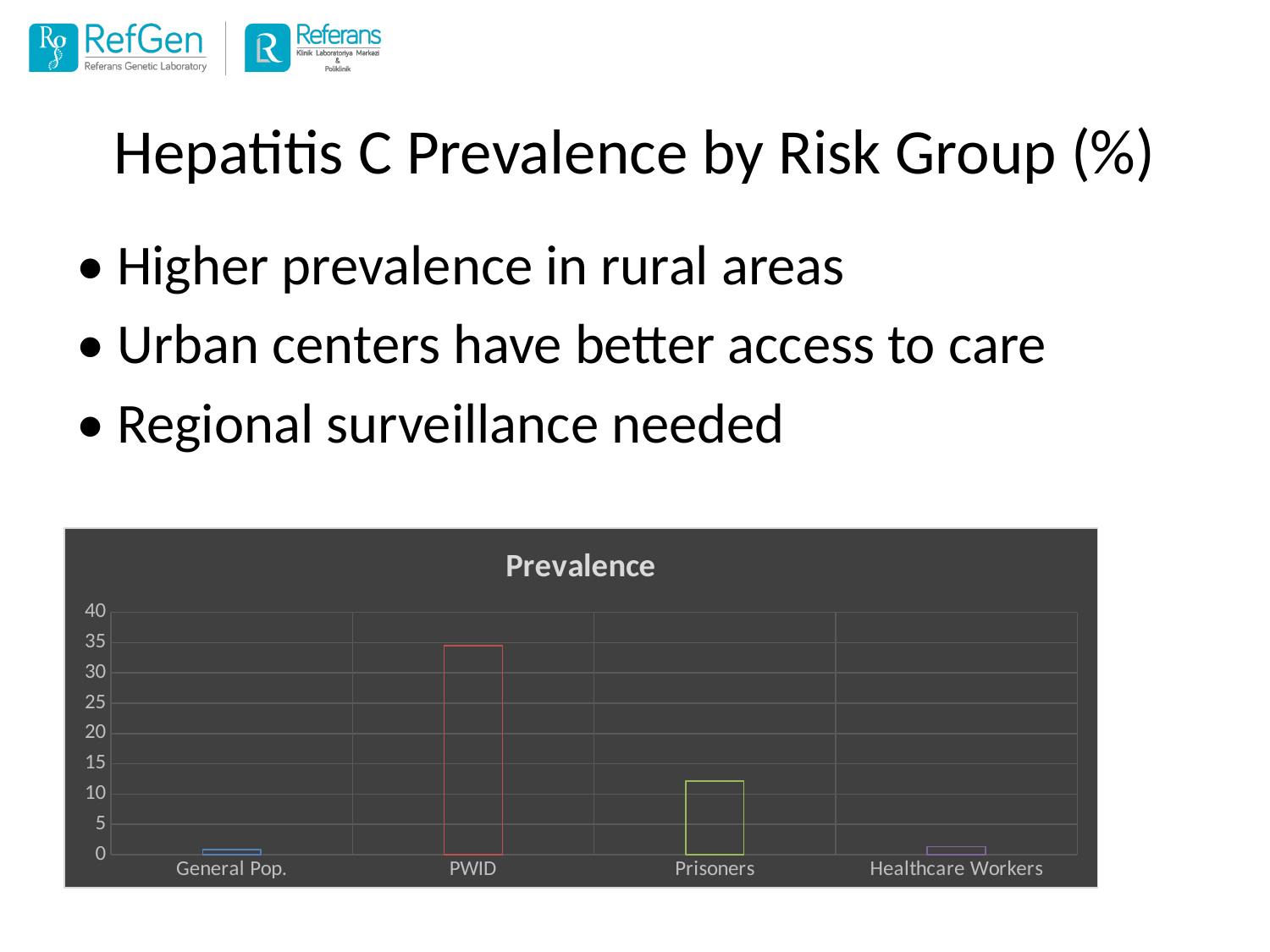
What is the title of the chart? Prevalence Which has a higher prevalence, PWID or Prisoners? PWID Is the value for Healthcare Workers greater or less than 5? less What kind of chart is shown on the slide? bar chart Is the value for PWID greater or less than 30? greater Is the value for Prisoners greater or less than 15? less Which risk group has the highest prevalence in the chart? PWID Which has a higher prevalence, Prisoners or Healthcare Workers? Prisoners How many risk groups are shown on the x axis of the chart? 4